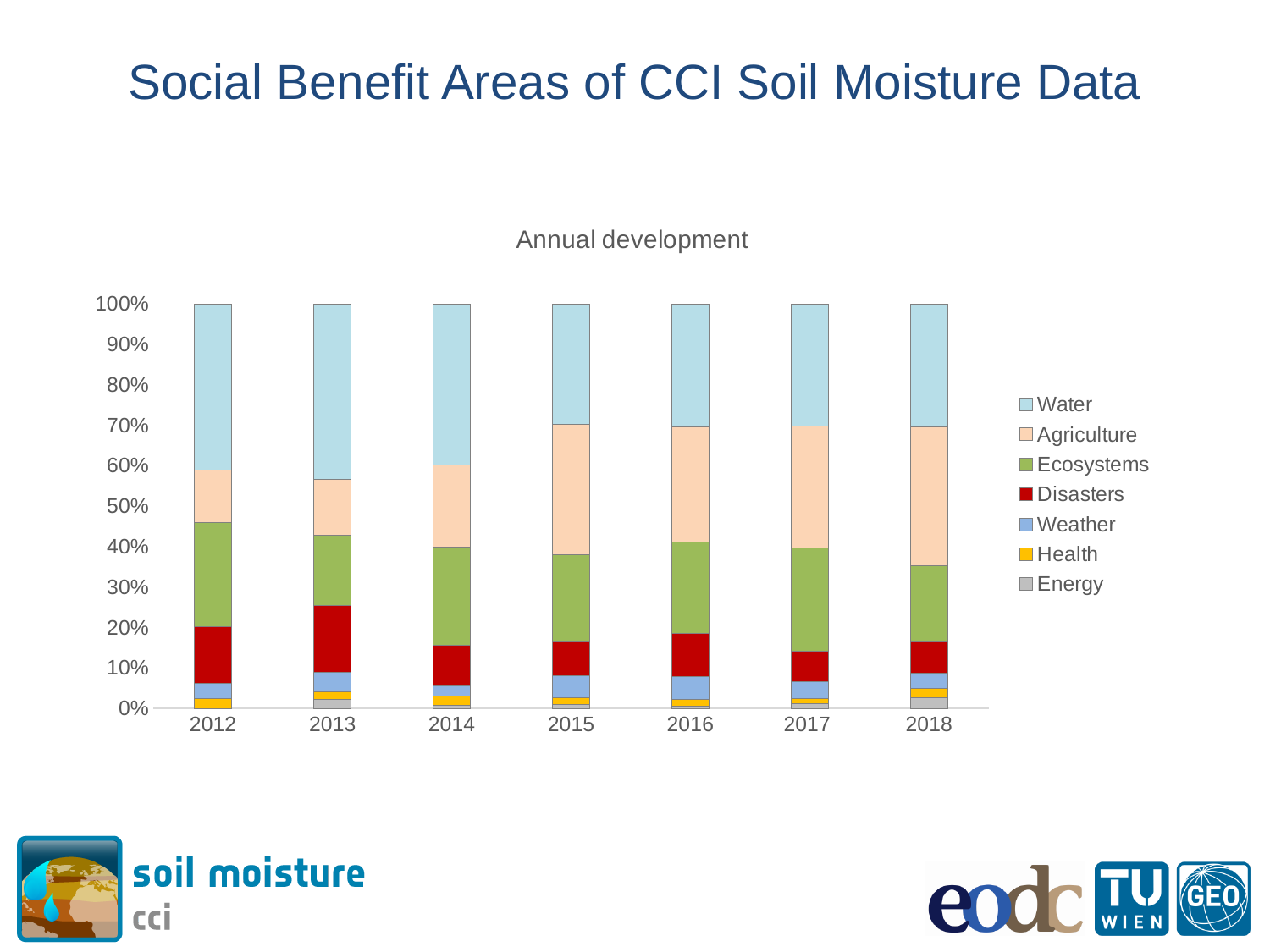
Is the Health share in 2012 greater or less than 10%? less How many years are shown on the x axis of the chart? 7 What is the total height of the stacked bar for 2015? 100% What is the title of the chart? Annual development How many series does the chart's legend list? 7 Is the Ecosystems share in 2012 greater or less than 20%? greater Is the Disasters share in 2013 greater or less than 10%? greater Which series has the largest share in 2012? Water Which colour represents the Disasters series in the chart? Red What kind of chart is shown on the slide? Stacked bar chart Which is larger, the Water share in 2012 or the Water share in 2018? 2012 Which is larger, the Agriculture share in 2012 or the Agriculture share in 2018? 2018